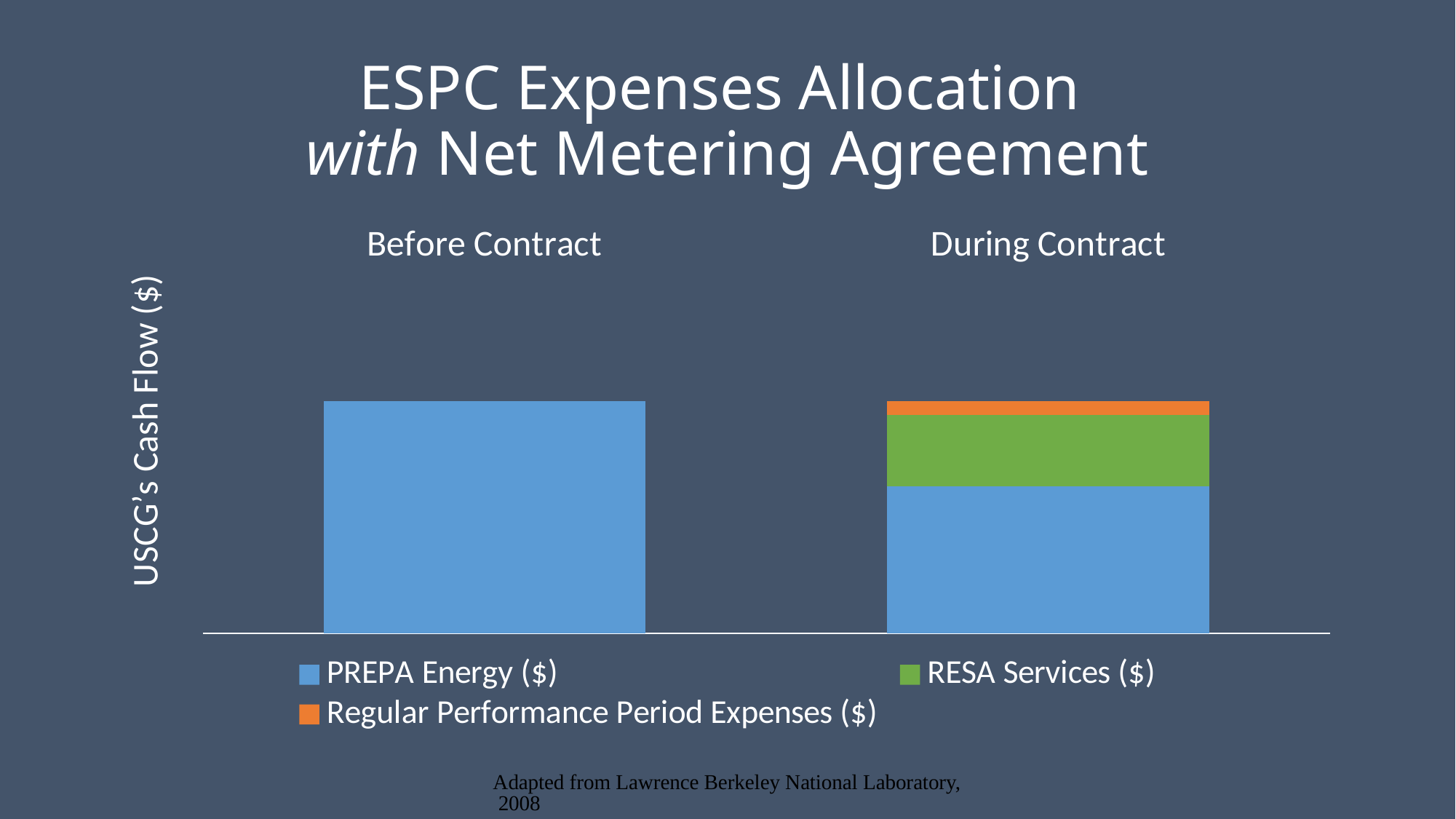
What kind of chart is shown on the slide? Stacked bar chart Which series appears only in the During Contract bar and not in the Before Contract bar? RESA Services ($) and Regular Performance Period Expenses ($) In the During Contract bar, which series has the largest segment? PREPA Energy ($) How many categories are shown on the x axis of the chart? 2 Which series makes up the entire Before Contract bar? PREPA Energy ($) How many series does the chart's legend list? 3 In the During Contract bar, is the RESA Services ($) segment larger or smaller than the Regular Performance Period Expenses ($) segment? Larger In the During Contract bar, which series has the smallest segment? Regular Performance Period Expenses ($) What is the label on the chart's y axis? USCG's Cash Flow ($) Is the PREPA Energy ($) value larger for Before Contract or During Contract? Before Contract What colour represents RESA Services ($) in the chart? Green